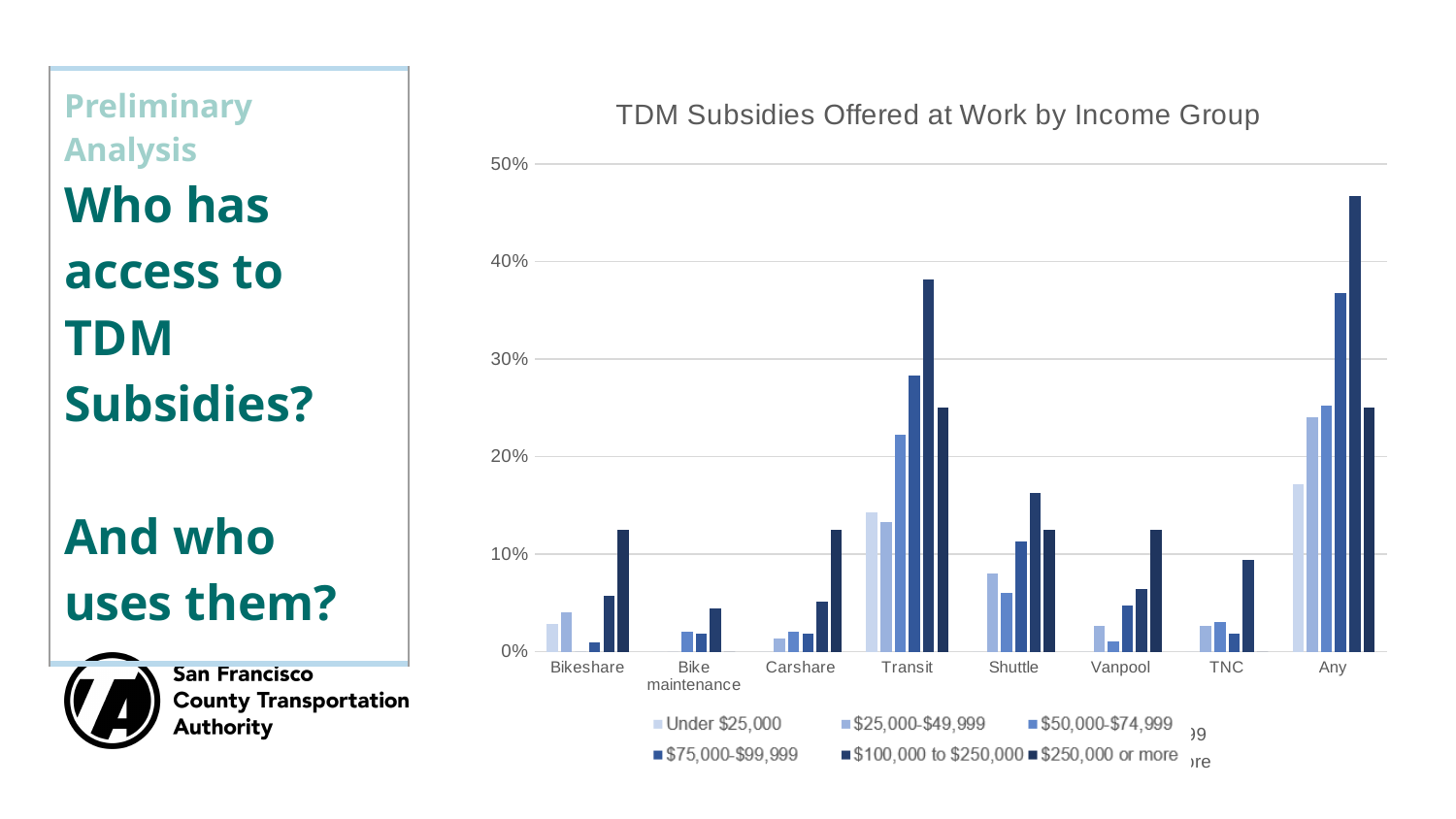
How many subsidy categories are shown along the x axis? 8 For the $250,000 or more group, which is larger: Bikeshare or Bike maintenance? Bikeshare What type of chart is shown on the slide? Bar chart Is the value for Transit in the $100,000 to $250,000 group greater or less than 30%? greater For the $100,000 to $250,000 group, which is larger: Transit or Shuttle? Transit How many income groups does the legend list? 6 Is the value for Transit in the Under $25,000 group greater or less than 20%? less Which category has the lowest bars overall? Bike maintenance Within the Transit category, which income group has the highest value? $100,000 to $250,000 What is the title of the chart? TDM Subsidies Offered at Work by Income Group Is the value for Any in the $100,000 to $250,000 group greater or less than 40%? greater Which category contains the tallest bar in the chart? Any